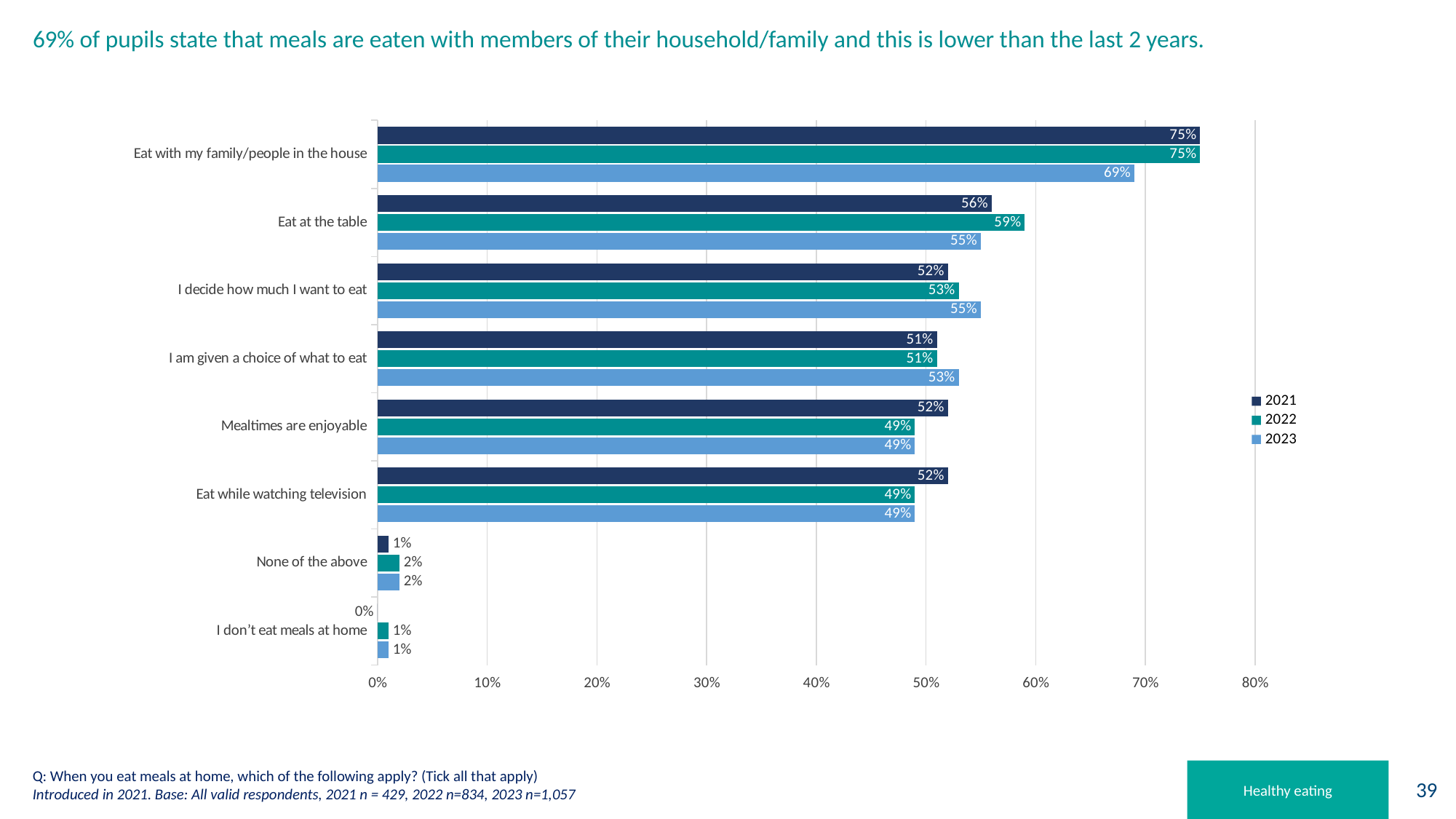
How many series does the legend list? 3 Which is larger for "Eat at the table": the 2022 value or the 2023 value? 2022 Which years does the legend list? 2021, 2022, 2023 What is the 2023 value for "Eat with my family/people in the house"? 69% Which category has the lowest value in 2021? I don't eat meals at home How many categories are shown on the chart? 8 What is the 2022 value for "Eat at the table"? 59% What kind of chart is shown on the slide? Bar chart Which category has the highest value in 2023? Eat with my family/people in the house What is the difference between the 2022 and 2023 values for "I decide how much I want to eat"? 2% What is the 2021 value for "Mealtimes are enjoyable"? 52% What is the difference between the 2021 and 2023 values for "Eat with my family/people in the house"? 6%